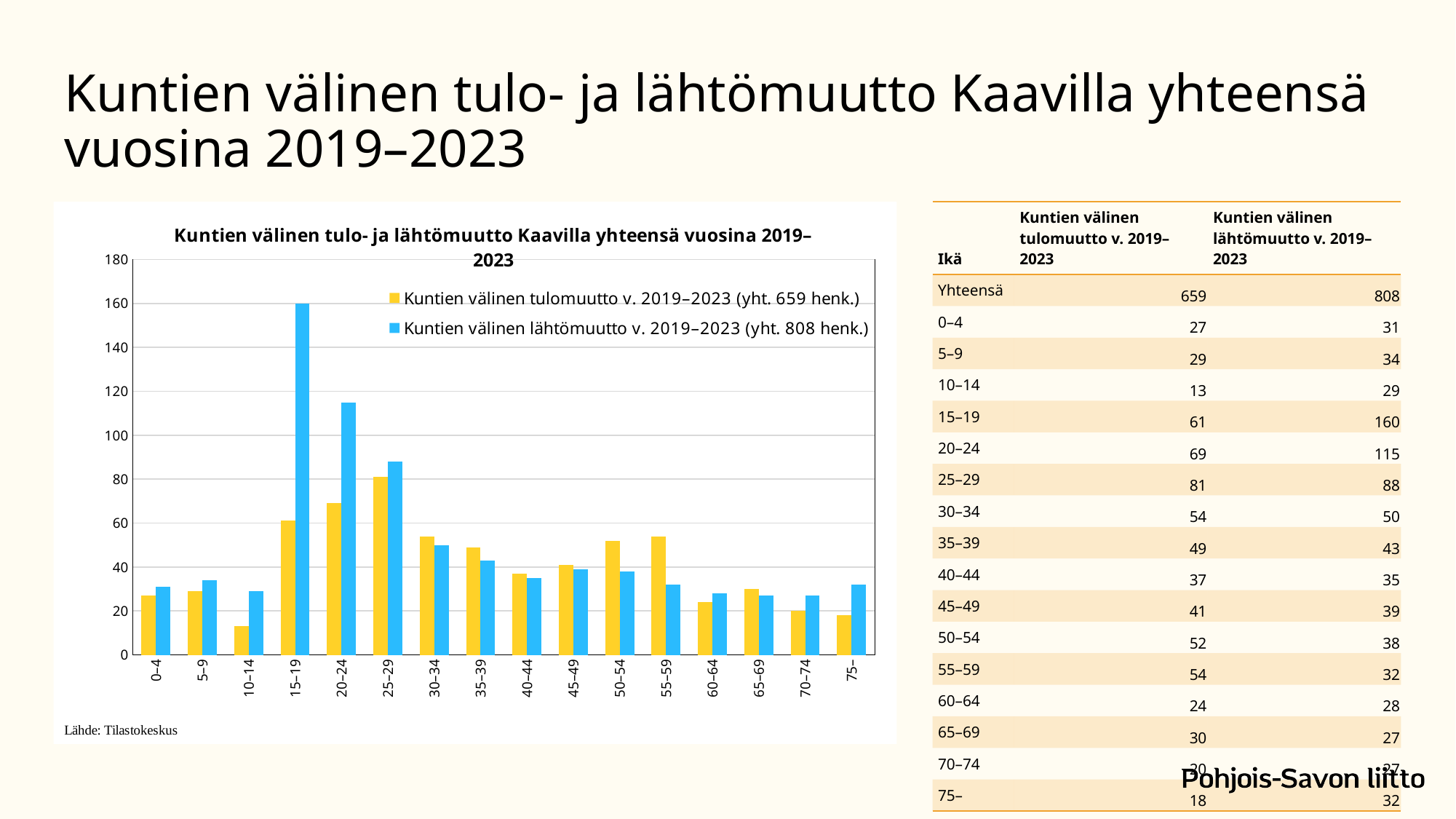
What is the value of Kuntien välinen tulomuutto v. 2019–2023 for the 25–29 age group? 81 Is the value for Kuntien välinen lähtömuutto v. 2019–2023 in the 20–24 age group greater or less than 100? greater What is the value of Kuntien välinen lähtömuutto v. 2019–2023 for the 15–19 age group? 160 How many age groups are shown on the x axis of the chart? 16 For the 55–59 age group, which is larger: tulomuutto or lähtömuutto? tulomuutto How many series does the chart legend list? 2 What kind of chart is shown on the slide? bar chart Which age group has the lowest value for Kuntien välinen tulomuutto v. 2019–2023? 10–14 Is the value for Kuntien välinen tulomuutto v. 2019–2023 in the 10–14 age group greater or less than 20? less What is the difference between lähtömuutto and tulomuutto for the 20–24 age group? 46 According to the legend, what is the total number of people (yht.) for Kuntien välinen lähtömuutto v. 2019–2023? 808 henk. Which age group has the highest value for Kuntien välinen lähtömuutto v. 2019–2023? 15–19